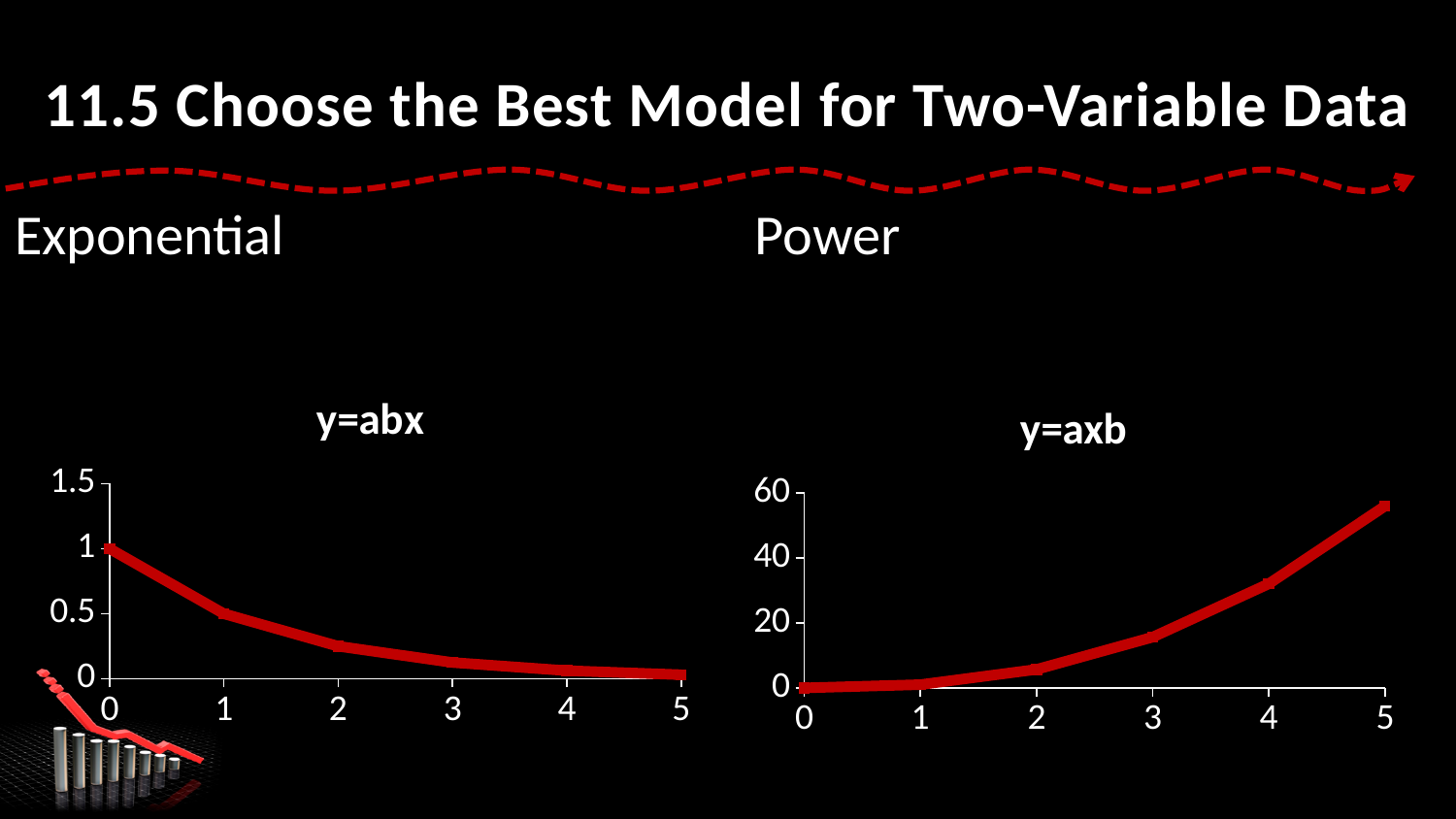
What kind of chart is the chart titled y=abx? line chart In the chart titled y=axb, which is larger, the value at x = 4 or the value at x = 2? x = 4 In the chart titled y=axb, is the value at x = 3 greater or less than 20? less In the chart titled y=abx, at which x value is the plotted value highest? 0 In the chart titled y=axb, is the value at x = 5 greater or less than 40? greater In the chart titled y=abx, what is the value at x = 0? 1 In the chart titled y=abx, what is the value at x = 1? 0.5 What kind of chart is the chart titled y=axb? line chart In the chart titled y=axb, at which x value is the plotted value highest? 5 In the chart titled y=axb, do the values rise or fall as x increases from 0 to 5? rise In the chart titled y=abx, do the values rise or fall as x increases from 0 to 5? fall In the chart titled y=axb, what is the value at x = 0? 0